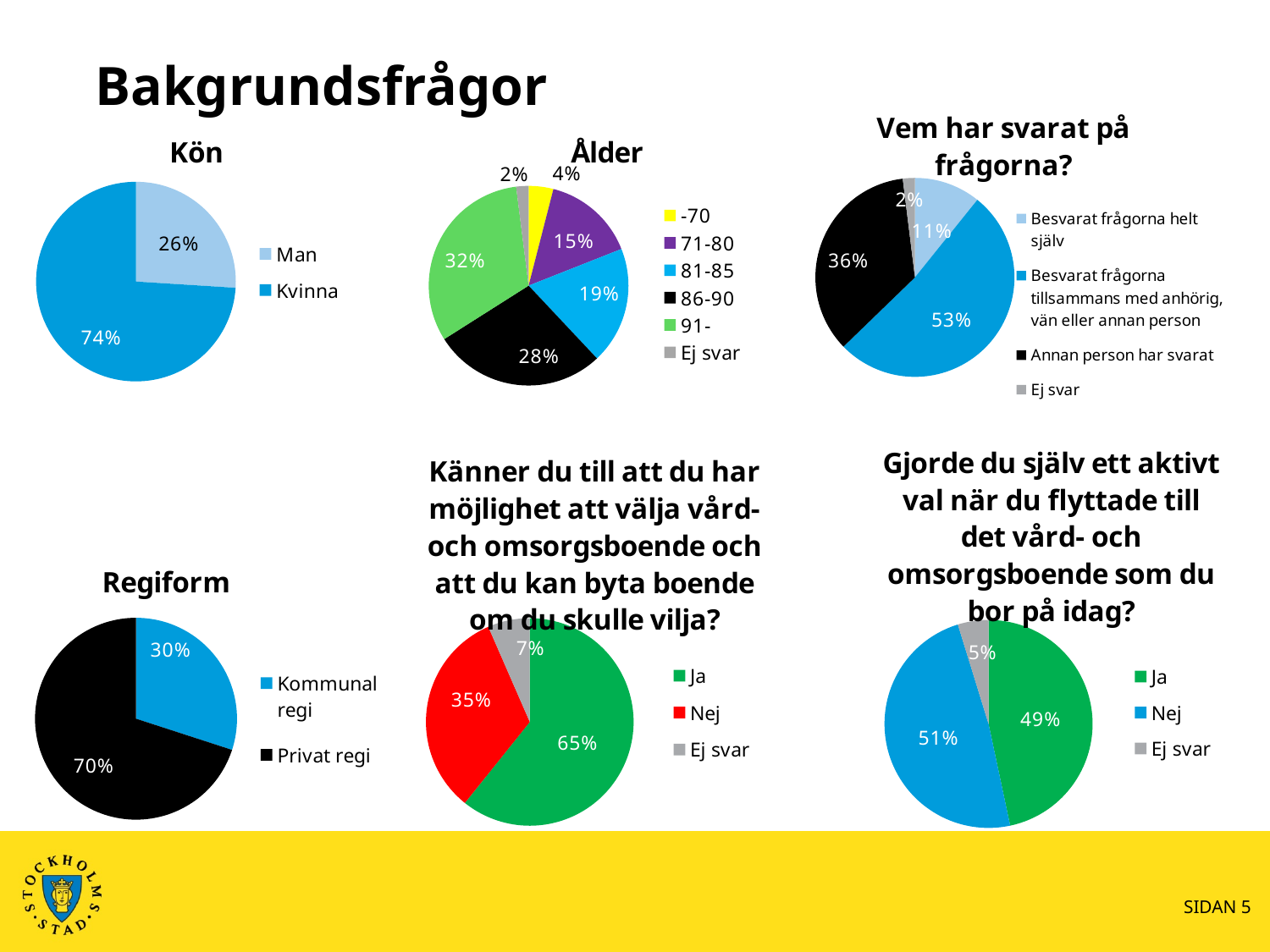
In the "Ålder" chart, what share is labelled for the 86-90 group? 28% In the "Kön" chart, what share is labelled for Kvinna? 74% In the "Gjorde du själv ett aktivt val..." chart, what share is labelled for Nej? 51% In the "Vem har svarat på frågorna?" chart, which category has the smallest slice? Ej svar In the "Vem har svarat på frågorna?" chart, what share is labelled for "Besvarat frågorna tillsammans med anhörig, vän eller annan person"? 53% In the "Känner du till att du har möjlighet att välja vård- och omsorgsboende..." chart, which is larger, Ja or Nej? Ja In the "Ålder" chart, what is the difference between the 81-85 share and the 71-80 share? 4% In the "Ålder" chart, how many entries does the legend list? 6 What type of chart is the "Regiform" chart? Pie chart In the "Kön" chart, what share is labelled for Man? 26% In the "Ålder" chart, which age group has the largest slice? 91- In the "Regiform" chart, what share is labelled for Privat regi? 70%